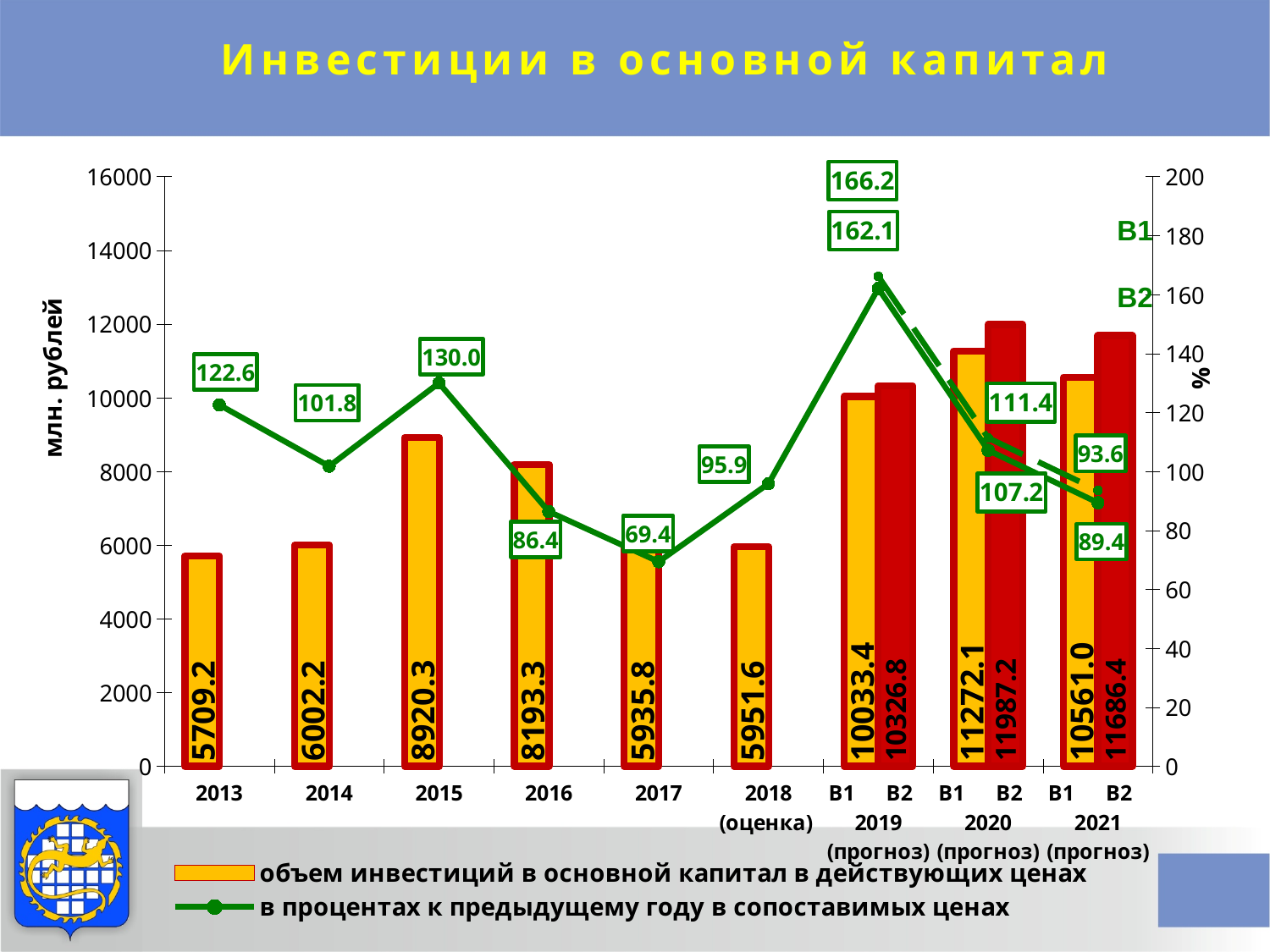
What is the investment volume (млн. рублей) shown for 2015? 8920.3 Which bar has the highest investment volume? B2 2020 (прогноз) What is the investment volume shown for the B2 variant of 2020 (прогноз)? 11987.2 How many series does the legend list? 2 What is the title of the chart? Инвестиции в основной капитал Which year has the lowest investment volume among 2013–2018? 2013 Is the investment volume for 2018 (оценка) greater or less than 6000 млн. рублей? less What percentage to the previous year is shown for 2015? 130.0 What is the investment volume shown for 2013? 5709.2 What percentage to the previous year is shown for 2017? 69.4 Which is larger, the investment volume for 2016 or for 2017? 2016 What is the difference between the B2 and B1 investment volumes for 2021 (прогноз)? 1125.4